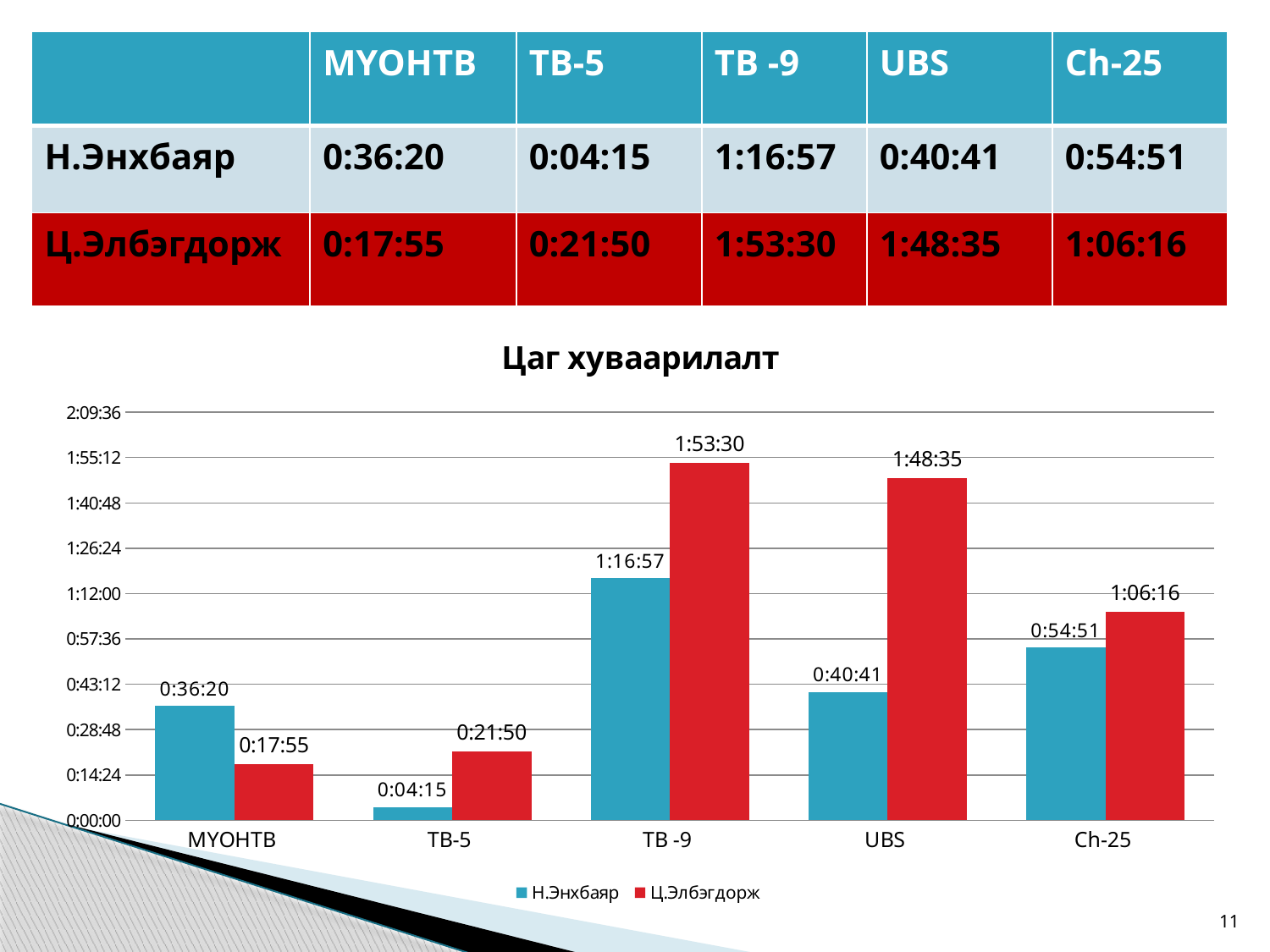
What is the difference between Ц.Элбэгдорж and Н.Энхбаяр at Ch-25? 0:11:25 Which colour represents Ц.Элбэгдорж in the chart? red How many categories are shown on the x axis of the chart? 5 Which category has the lowest value for Н.Энхбаяр? ТВ-5 Which category has the highest value for Ц.Элбэгдорж? ТВ -9 What is the chart's title? Цаг хуваарилалт What is the value for Н.Энхбаяр at ТВ-5? 0:04:15 What is the value for Ц.Элбэгдорж at ТВ -9? 1:53:30 What is the value for Н.Энхбаяр at UBS? 0:40:41 Which is larger at МҮОНТВ: the value for Н.Энхбаяр or for Ц.Элбэгдорж? Н.Энхбаяр How many series does the legend list? 2 What type of chart is shown on the slide? bar chart